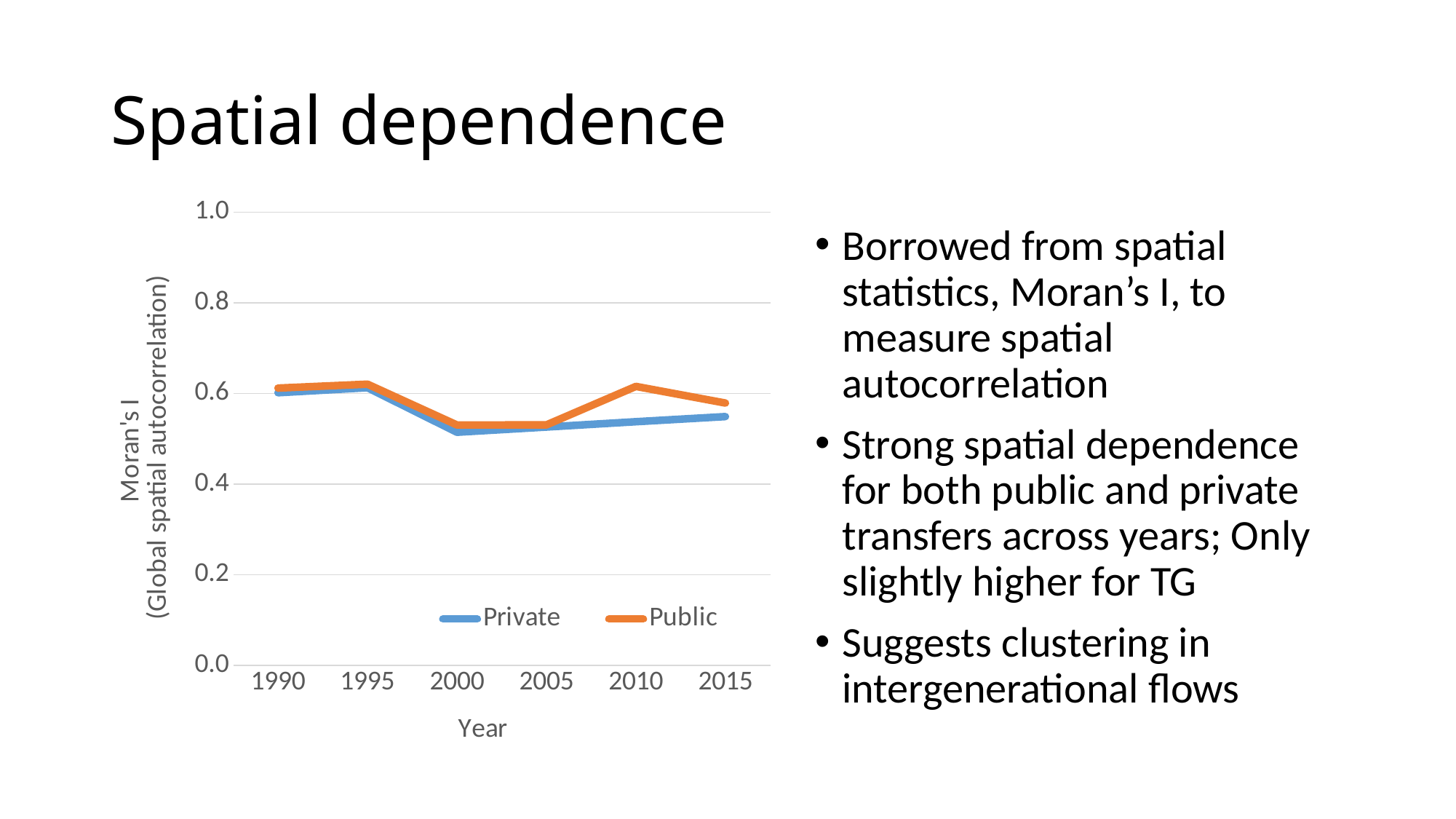
What kind of chart is shown on the slide? line chart How many years are plotted along the x axis of the chart? 6 Is the Private value for 2000 greater or less than 0.6? less What is the title of the x axis of the chart? Year In 2010, which series has the higher value, Private or Public? Public How many series does the chart's legend list? 2 Which two series are listed in the chart's legend? Private and Public Is the Public value for 2015 greater or less than 0.6? less Does the Private series rise or fall between 1995 and 2000? fall Does the Public series rise or fall between 2005 and 2010? rise Is the Private value for 1990 greater or less than 0.4? greater